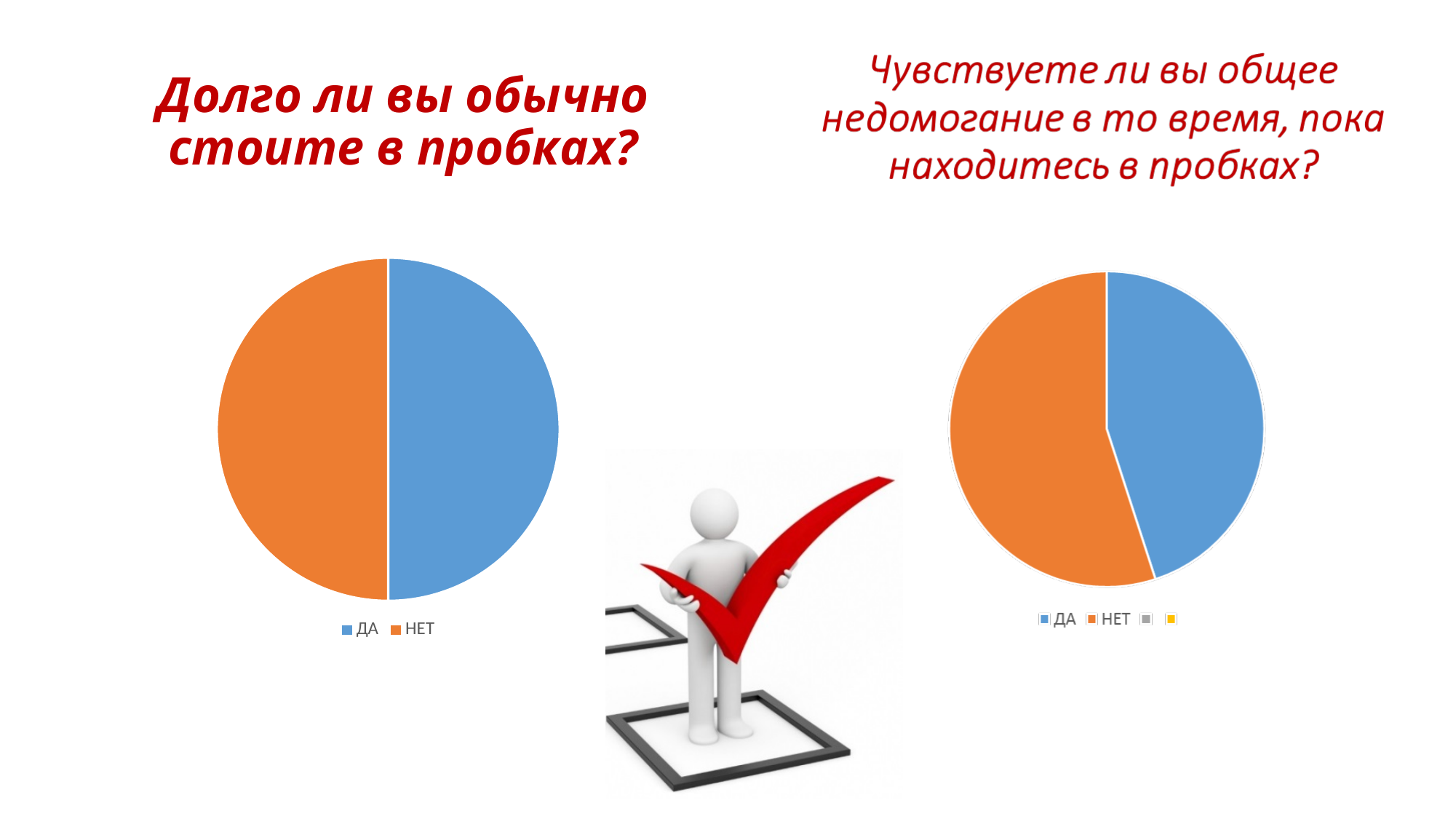
What kind of chart is the left chart titled "Долго ли вы обычно стоите в пробках?"? pie chart In the right chart ("Чувствуете ли вы общее недомогание..."), which slice is larger, ДА or НЕТ? НЕТ In the right chart ("Чувствуете ли вы общее недомогание..."), which answer has the smallest share? ДА How many slices does the left pie chart ("Долго ли вы обычно стоите в пробках?") have? 2 In the left chart ("Долго ли вы обычно стоите в пробках?"), what colour is the ДА slice? blue What kind of chart is the right chart titled "Чувствуете ли вы общее недомогание в то время, пока находитесь в пробках?"? pie chart What are the two labelled legend entries of the left chart ("Долго ли вы обычно стоите в пробках?")? ДА and НЕТ In the right chart ("Чувствуете ли вы общее недомогание..."), which answer has the largest share? НЕТ How many slices are visible in the right pie chart ("Чувствуете ли вы общее недомогание...")? 2